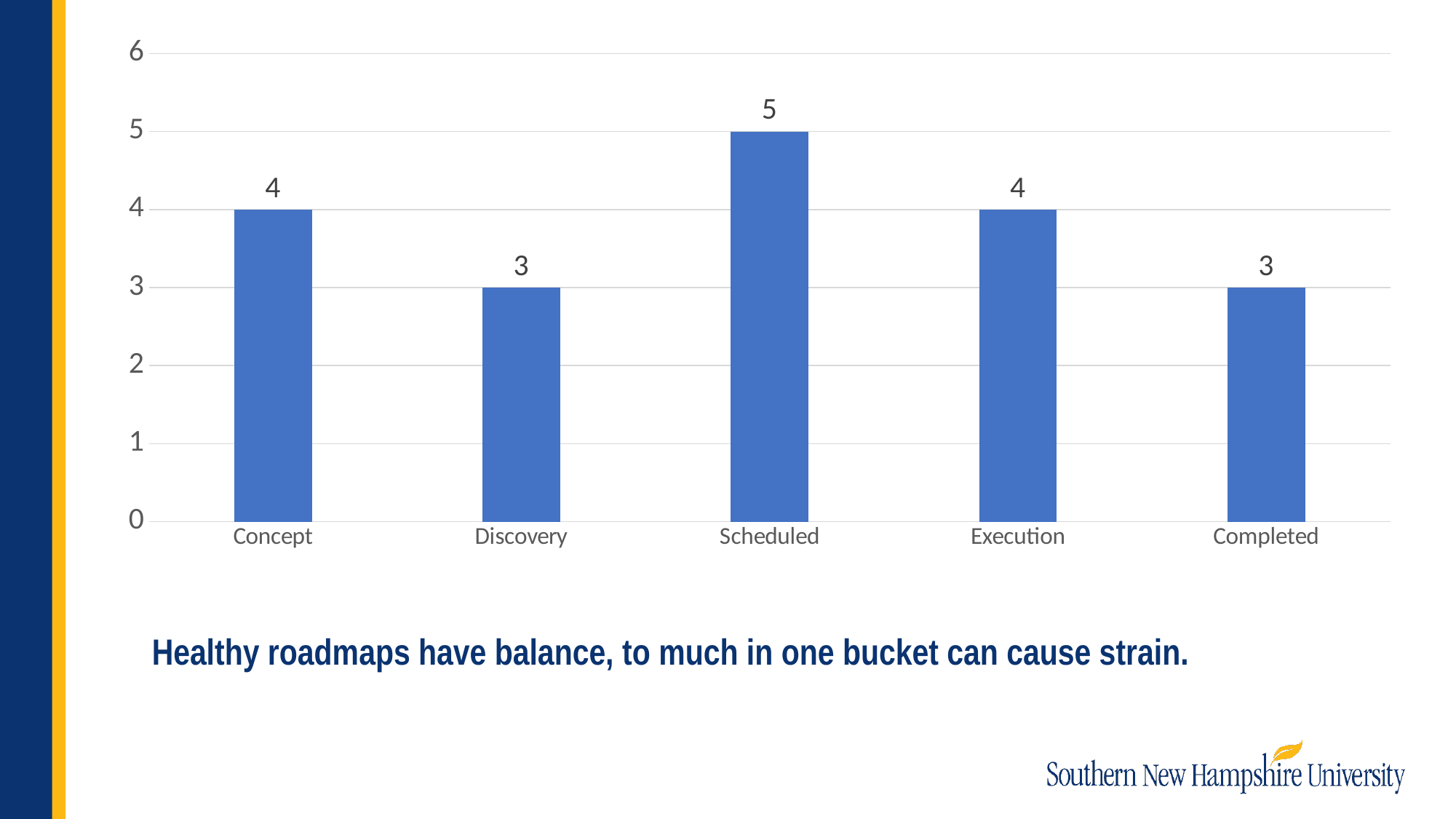
What is the difference between the values for Execution and Completed? 1 How many categories are shown on the x axis? 5 Which category has the highest value? Scheduled What is the value for Scheduled? 5 What is the value for Completed? 3 What is the difference between the values for Scheduled and Discovery? 2 What is the maximum value shown on the vertical axis? 6 Is the value for Scheduled greater or less than 4? greater Which is larger, the value for Concept or the value for Discovery? Concept What is the value for Discovery? 3 What kind of chart is shown on the slide? bar chart What is the value for Concept? 4